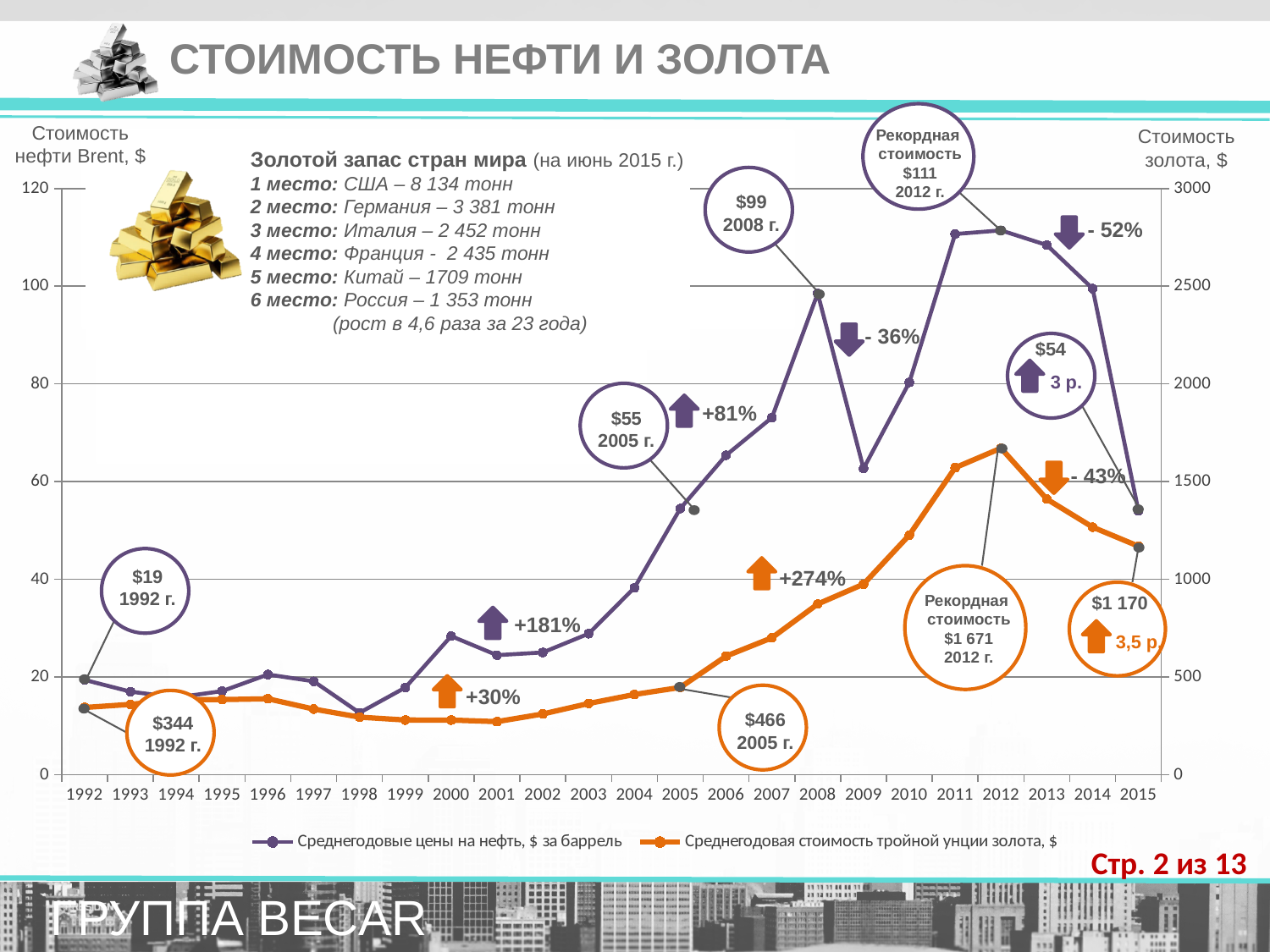
What was the record oil price shown for 2012? $111 In which year did the oil price reach its highest value? 2012 What was the record gold price shown for 2012? $1 671 How many years are shown on the x axis? 24 What was the average annual oil price in 2008 according to the callout? $99 Which is larger, the oil price in 2008 or in 2012? 2012 What was the average annual oil price in 1992 according to the callout? $19 How many series does the legend list? 2 Is the oil price value for 2000 greater or less than 20? greater What type of chart is shown on the slide? line chart What is the difference between the oil price in 2012 ($111) and in 1992 ($19)? $92 What was the gold price in 1992 according to the callout? $344